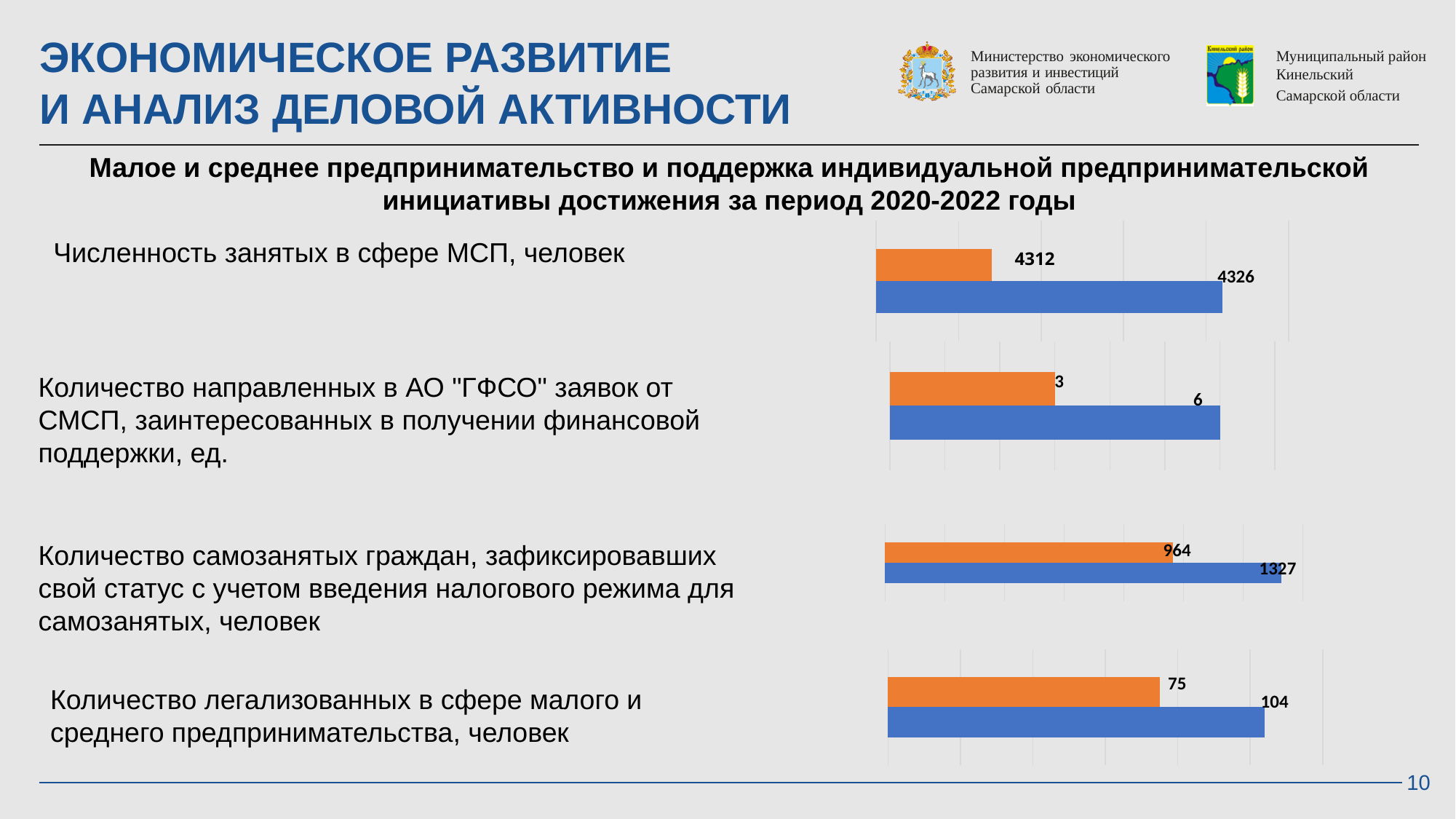
In the chart next to "Количество направленных в АО "ГФСО" заявок от СМСП...", what value is shown on the blue bar? 6 How many bars does the chart next to "Численность занятых в сфере МСП, человек" contain? 2 What type of chart is used next to "Количество легализованных в сфере малого и среднего предпринимательства, человек"? bar chart In the chart next to "Количество самозанятых граждан...", what value is shown on the blue bar? 1327 In the chart next to "Количество легализованных в сфере малого и среднего предпринимательства, человек", what is the difference between the blue bar and the orange bar? 29 In the chart next to "Количество самозанятых граждан...", what is the difference between the blue bar and the orange bar? 363 In the chart next to "Численность занятых в сфере МСП, человек", what value is shown on the blue bar? 4326 In the chart next to "Количество направленных в АО "ГФСО" заявок от СМСП...", what value is shown on the orange bar? 3 In the chart next to "Количество самозанятых граждан...", what value is shown on the orange bar? 964 In the chart next to "Численность занятых в сфере МСП, человек", what value is shown on the orange bar? 4312 In the chart next to "Количество легализованных в сфере малого и среднего предпринимательства, человек", what value is shown on the orange bar? 75 In the chart next to "Количество направленных в АО "ГФСО" заявок от СМСП...", which bar is larger, the orange or the blue? blue